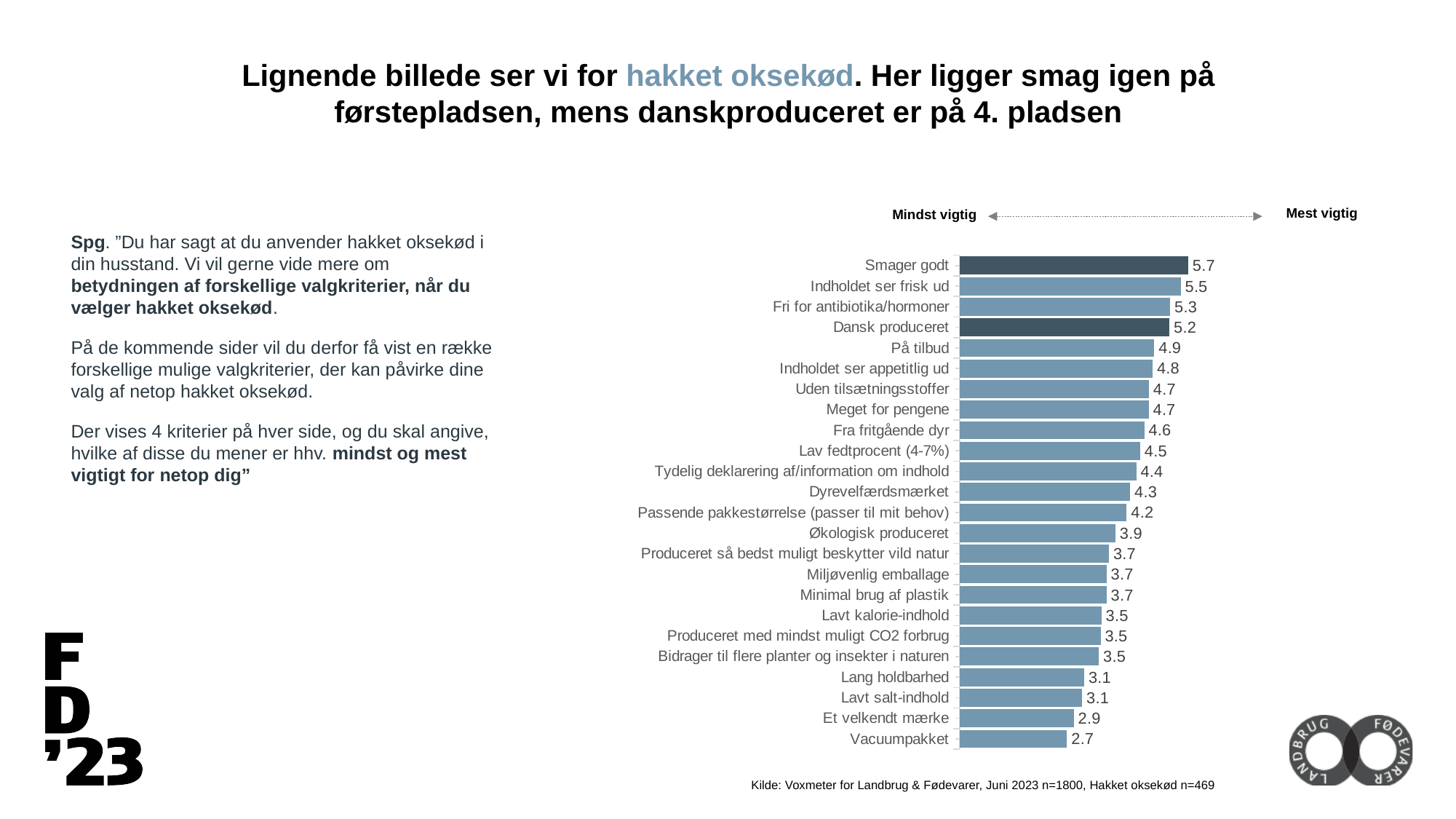
Which category has the lowest value? Vacuumpakket What is the difference between the values for "Indholdet ser frisk ud" and "Vacuumpakket"? 2.8 What is the label at the right end of the arrow above the chart? Mest vigtig Which has a larger value, "På tilbud" or "Fra fritgående dyr"? På tilbud What is the difference between the values for "Smager godt" and "Dansk produceret"? 0.5 Which has a larger value, "Et velkendt mærke" or "Lang holdbarhed"? Lang holdbarhed What is the value for "Økologisk produceret"? 3.9 Which category has the highest value? Smager godt What kind of chart is shown on the slide? Bar chart What is the value for "Lav fedtprocent (4-7%)"? 4.5 How many categories are shown in the chart? 24 What is the value for "Dansk produceret"? 5.2